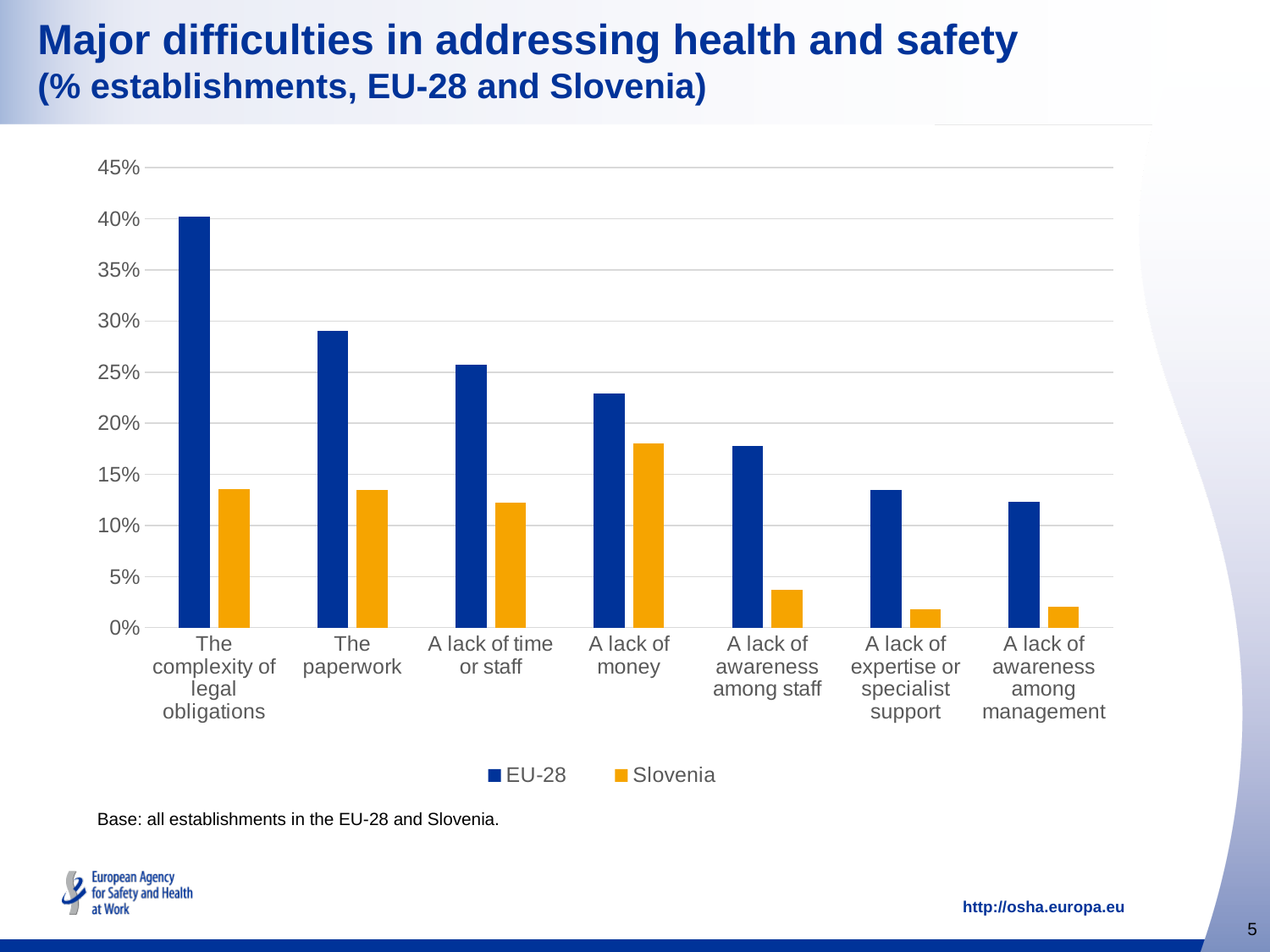
Which colour represents Slovenia in the chart? orange Is the EU-28 value for 'The complexity of legal obligations' greater or less than 35%? greater How many difficulty categories are shown on the x axis? 7 What kind of chart is shown on the slide? bar chart Is the Slovenia value for 'A lack of awareness among staff' greater or less than 5%? less How many series does the legend list? 2 Which category has the highest Slovenia value? A lack of money Which category has the highest EU-28 value? The complexity of legal obligations Is the EU-28 value for 'A lack of awareness among staff' greater or less than 20%? less Do the EU-28 values rise or fall moving from left to right along the x axis? fall For 'A lack of money', which series has the larger value, EU-28 or Slovenia? EU-28 Which category has the lowest EU-28 value? A lack of awareness among management